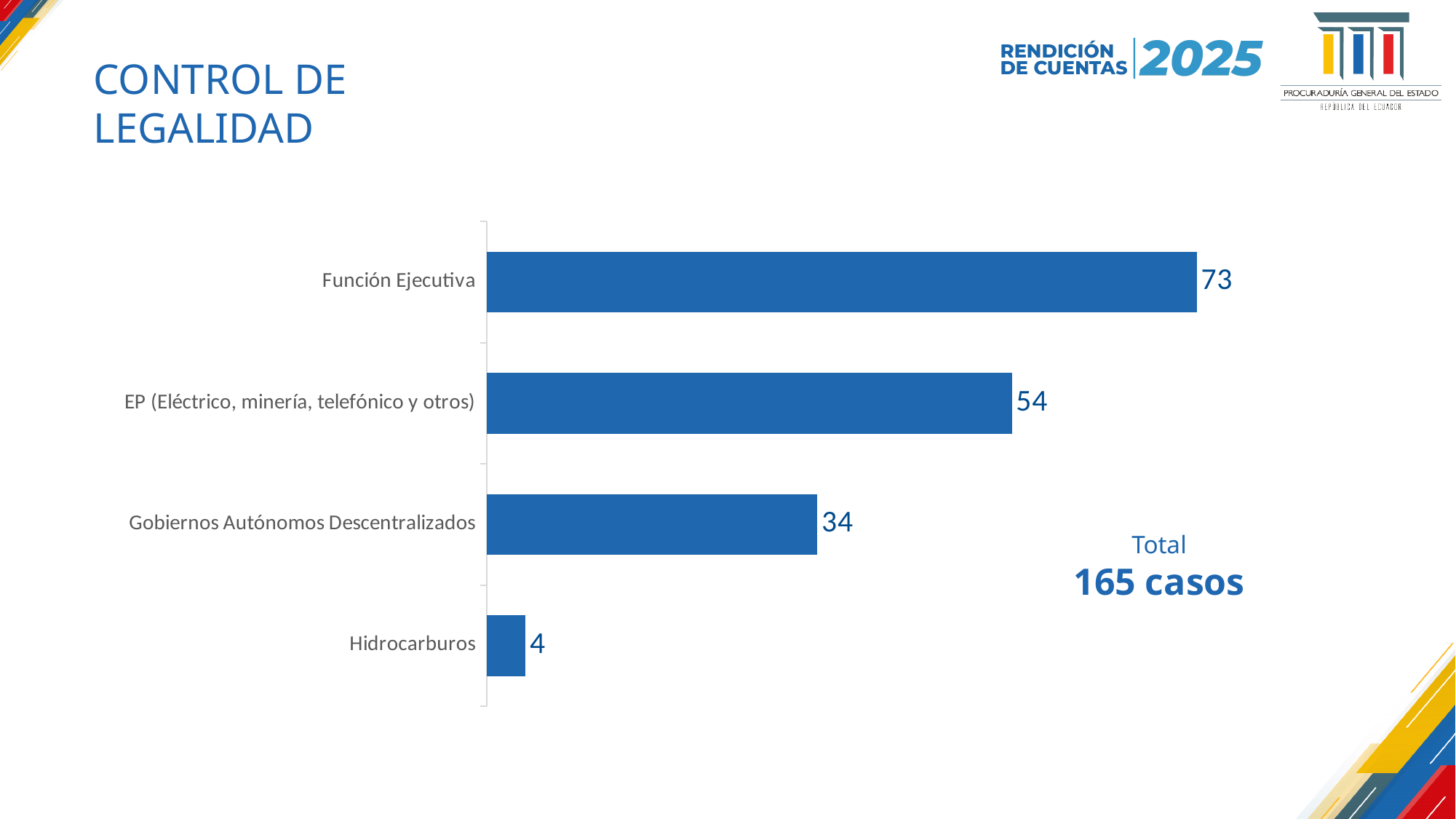
What total number of cases is stated next to the chart? 165 casos Which category has the lowest value? Hidrocarburos What is the difference between the values for Gobiernos Autónomos Descentralizados and Hidrocarburos? 30 What is the value for Función Ejecutiva? 73 Which is larger, the value for EP (Eléctrico, minería, telefónico y otros) or the value for Gobiernos Autónomos Descentralizados? EP (Eléctrico, minería, telefónico y otros) How many categories are shown in the chart? 4 What kind of chart is shown on the slide? Bar chart What is the value for Hidrocarburos? 4 What is the value for EP (Eléctrico, minería, telefónico y otros)? 54 What is the difference between the values for Función Ejecutiva and EP (Eléctrico, minería, telefónico y otros)? 19 What is the value for Gobiernos Autónomos Descentralizados? 34 Which category has the highest value? Función Ejecutiva